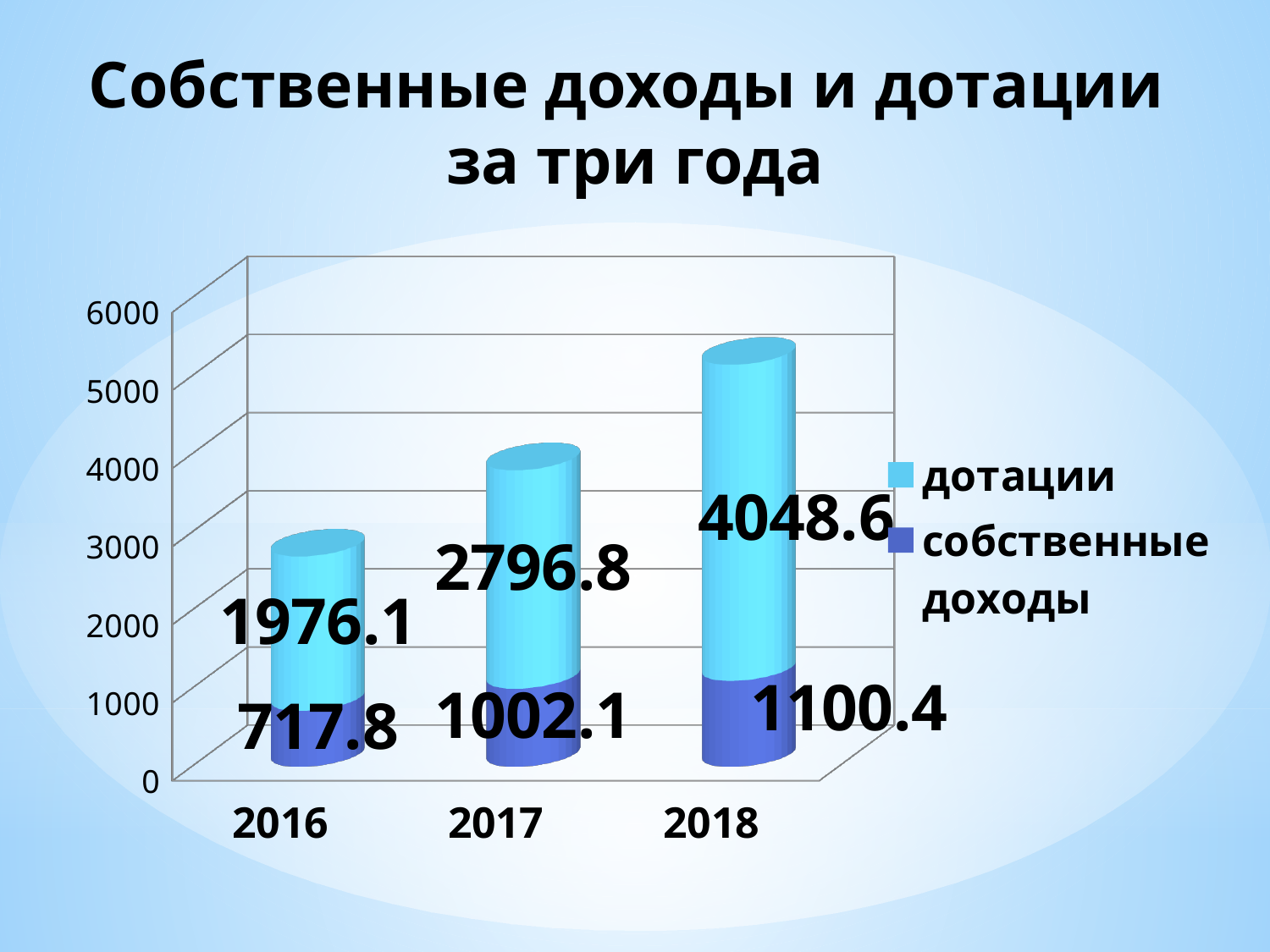
What is the difference between собственные доходы in 2017 and собственные доходы in 2016? 284.3 Which year has the lowest value of собственные доходы? 2016 How many series does the legend list? 2 What is the difference between дотации in 2018 and дотации in 2017? 1251.8 Which year has the highest value of дотации? 2018 What is the value of дотации for 2017? 2796.8 What is the value of собственные доходы for 2018? 1100.4 What is the value of дотации for 2016? 1976.1 What is the total of the stacked bar for 2017? 3798.9 Do the values of дотации rise or fall from 2016 to 2018? rise Which is larger: дотации in 2016 or собственные доходы in 2018? дотации in 2016 How many years are shown on the x axis? 3